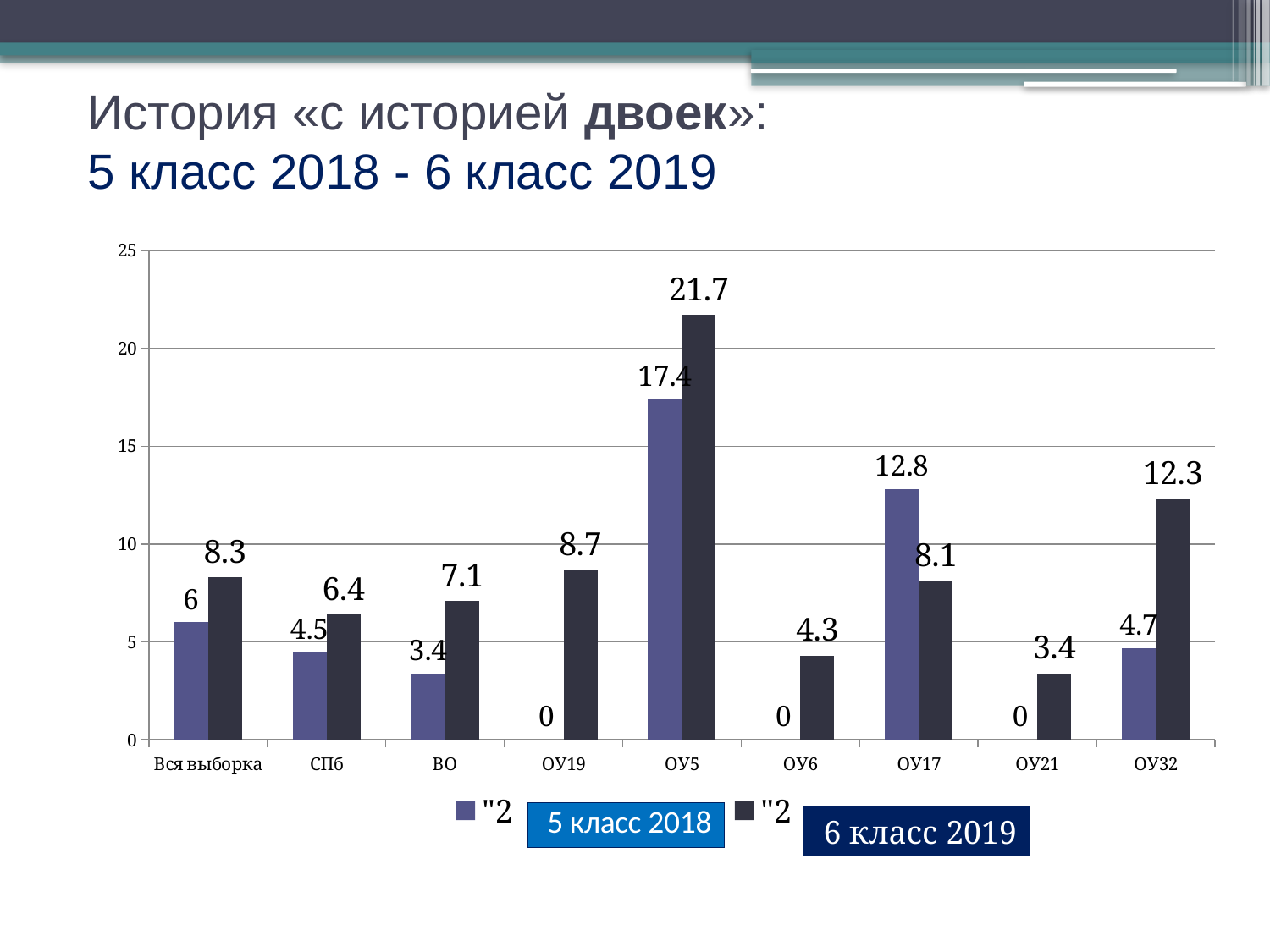
What is the value for ОУ17 in the 5 класс 2018 series? 12.8 How many series does the chart show? 2 What is the value for ОУ5 in the 6 класс 2019 series? 21.7 How many categories are shown on the x axis? 9 How many categories have a value of 0 in the 5 класс 2018 series? 3 What is the value for ОУ19 in the 6 класс 2019 series? 8.7 What is the value for Вся выборка in the 5 класс 2018 series? 6 Which category has the highest value in the 6 класс 2019 series? ОУ5 For ОУ17, which series has the larger value: 5 класс 2018 or 6 класс 2019? 5 класс 2018 Which category has the lowest value in the 6 класс 2019 series? ОУ21 What kind of chart is shown on the slide? bar chart What is the difference between the 6 класс 2019 and 5 класс 2018 values for ОУ32? 7.6